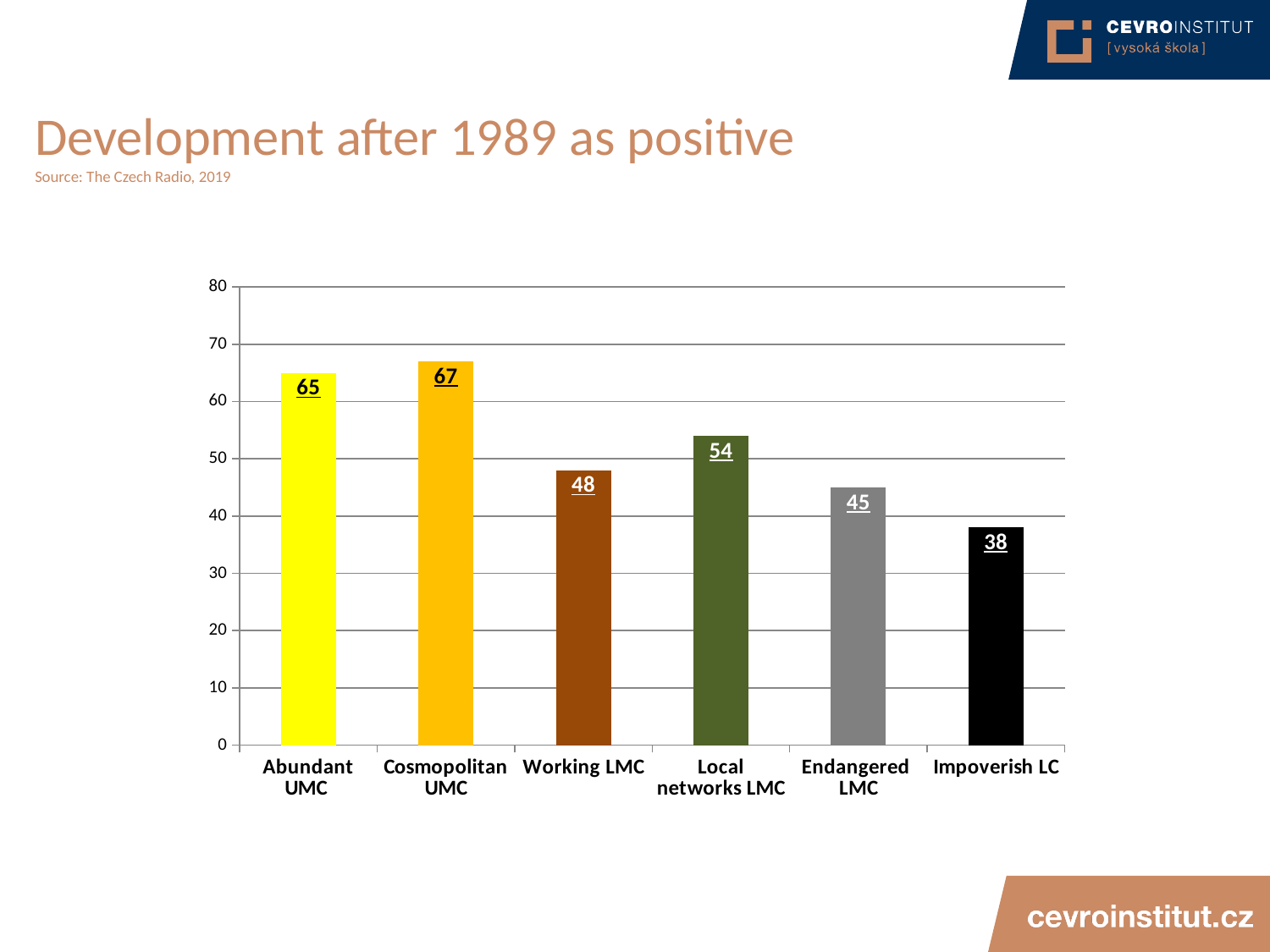
What is the value for Abundant UMC? 65 Which category has the lowest value? Impoverish LC Which category has the highest value? Cosmopolitan UMC How many categories are shown on the x axis? 6 Is the value for Endangered LMC greater or less than 50? less What is the value for Impoverish LC? 38 What kind of chart is shown on the slide? bar chart What colour is the bar for Working LMC? brown What is the title of the slide? Development after 1989 as positive What is the difference between the values for Cosmopolitan UMC and Working LMC? 19 What is the value for Local networks LMC? 54 Which is larger, the value for Local networks LMC or the value for Endangered LMC? Local networks LMC